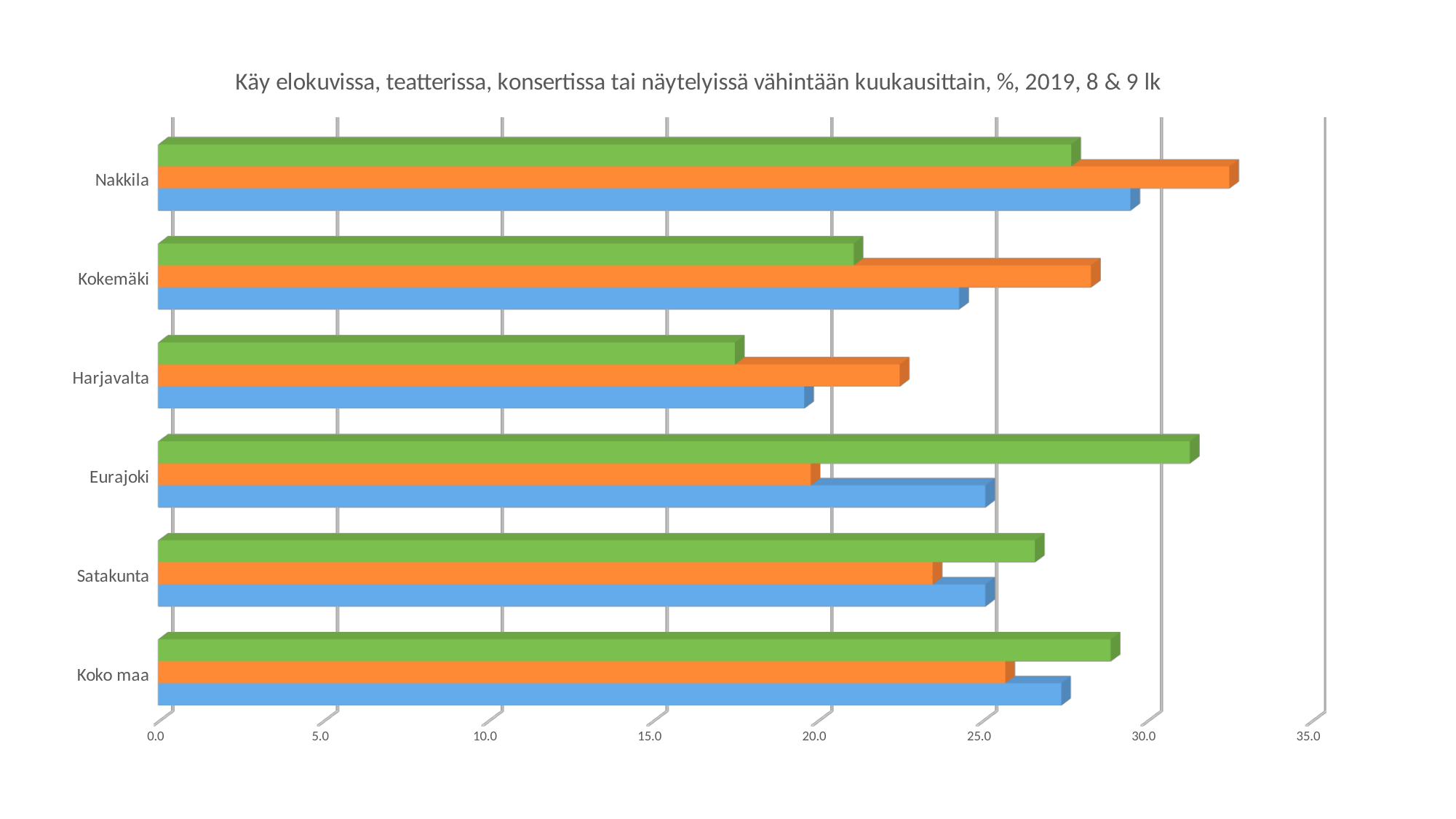
Which category has the longest green bar? Eurajoki How many categories are shown on the vertical axis of the chart? 6 Which category has the longest orange bar? Nakkila Is the value of the green bar for Harjavalta greater or less than 20? less Which category has the shortest orange bar? Eurajoki How many bars are plotted for each category in the chart? 3 For Eurajoki, which is larger, the green bar or the orange bar? the green bar Which category has the shortest blue bar? Harjavalta What kind of chart is shown on the slide? bar chart What is the title of the chart? Käy elokuvissa, teatterissa, konsertissa tai näytelyissä vähintään kuukausittain, %, 2019, 8 & 9 lk Is the value of the orange bar for Nakkila greater or less than 30? greater Is the value of the green bar for Eurajoki greater or less than 30? greater